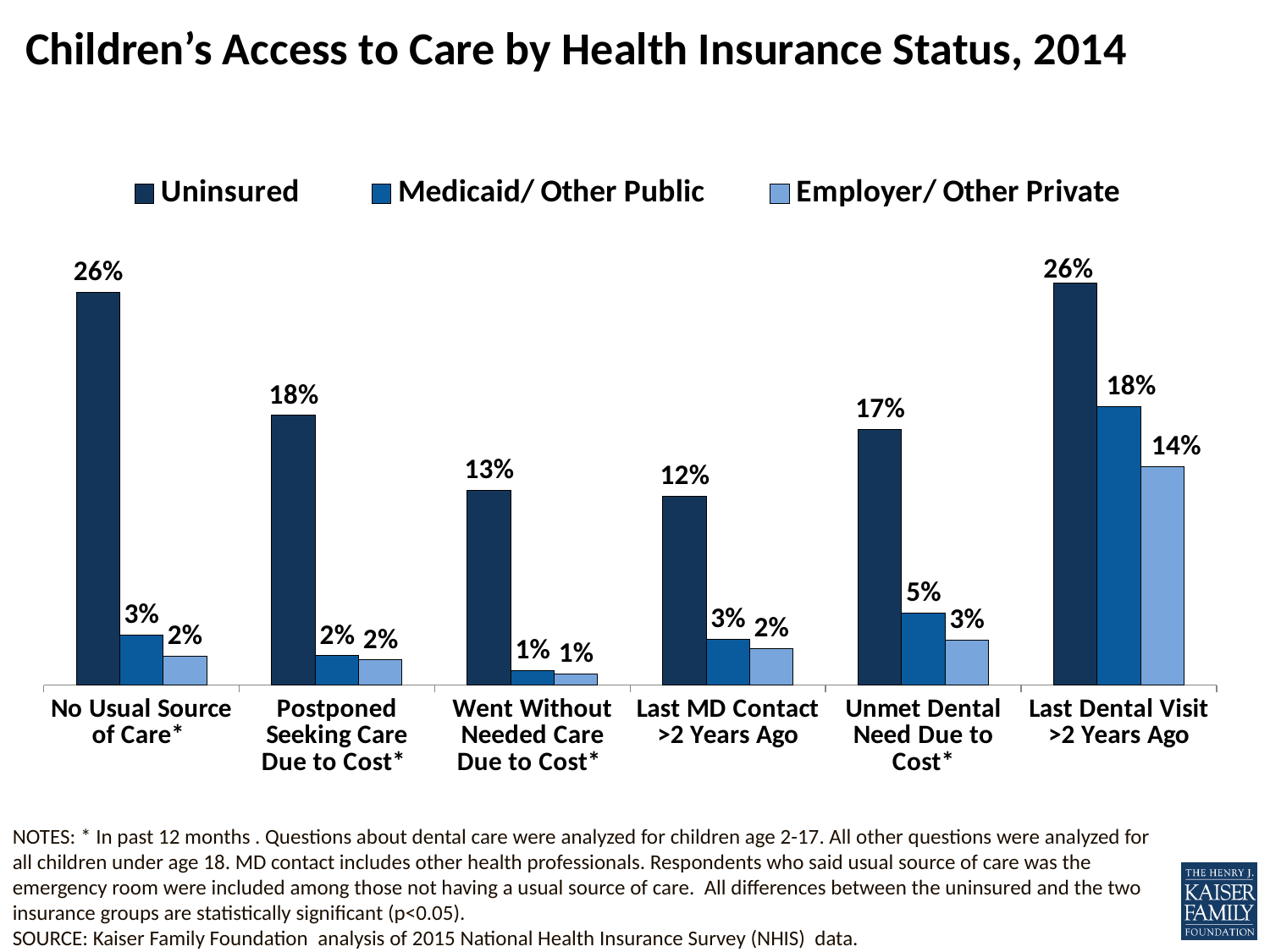
What kind of chart is shown on the slide? Bar chart What is the value for Uninsured in the 'No Usual Source of Care*' category? 26% What is the difference between the Uninsured and Medicaid/ Other Public values in the 'Postponed Seeking Care Due to Cost*' category? 16% How many series does the legend list? 3 What is the value for Medicaid/ Other Public in the 'Last Dental Visit >2 Years Ago' category? 18% Which category has the highest Employer/ Other Private value? Last Dental Visit >2 Years Ago Which category has the lowest Uninsured value? Last MD Contact >2 Years Ago Which is larger in the 'Unmet Dental Need Due to Cost*' category: the Medicaid/ Other Public value or the Employer/ Other Private value? Medicaid/ Other Public What is the title of the chart? Children's Access to Care by Health Insurance Status, 2014 How many categories are shown on the x axis? 6 What is the value for Uninsured in the 'Went Without Needed Care Due to Cost*' category? 13% What is the value for Employer/ Other Private in the 'Unmet Dental Need Due to Cost*' category? 3%